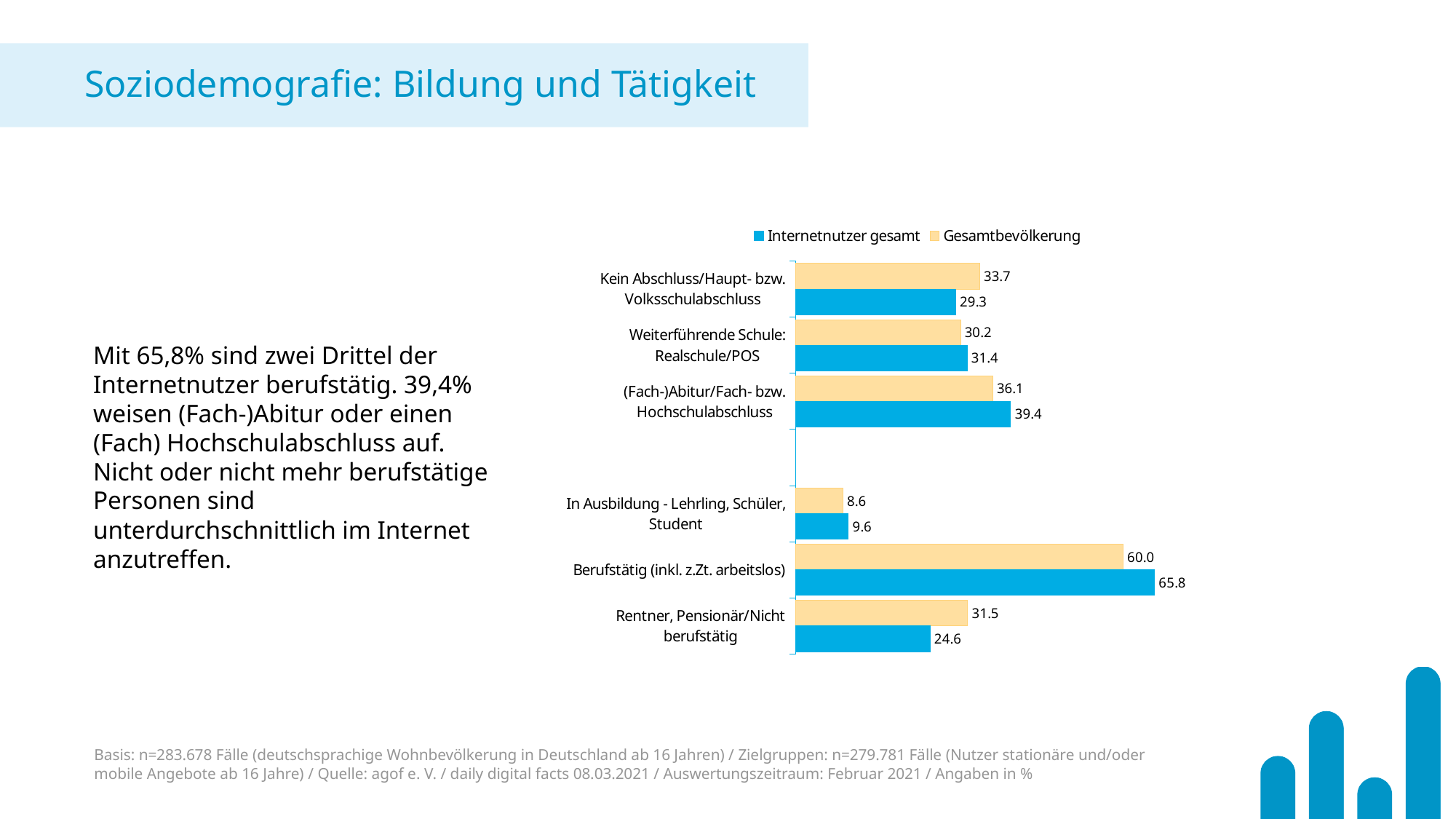
What is the value for Internetnutzer gesamt in the category (Fach-)Abitur/Fach- bzw. Hochschulabschluss? 39.4 What is the value for Gesamtbevölkerung in the category Rentner, Pensionär/Nicht berufstätig? 31.5 Which category has the lowest value for Gesamtbevölkerung? In Ausbildung - Lehrling, Schüler, Student Which category has the highest value for Internetnutzer gesamt? Berufstätig (inkl. z.Zt. arbeitslos) What kind of chart is shown on the slide? bar chart What is the difference between Internetnutzer gesamt and Gesamtbevölkerung in the category Berufstätig (inkl. z.Zt. arbeitslos)? 5.8 How many labeled categories are shown on the chart? 6 How many series does the legend list? 2 What is the value for Internetnutzer gesamt in the category Berufstätig (inkl. z.Zt. arbeitslos)? 65.8 Which series is shown in blue in the legend? Internetnutzer gesamt In the category Rentner, Pensionär/Nicht berufstätig, which series has the larger value: Internetnutzer gesamt or Gesamtbevölkerung? Gesamtbevölkerung What is the value for Gesamtbevölkerung in the category Kein Abschluss/Haupt- bzw. Volksschulabschluss? 33.7